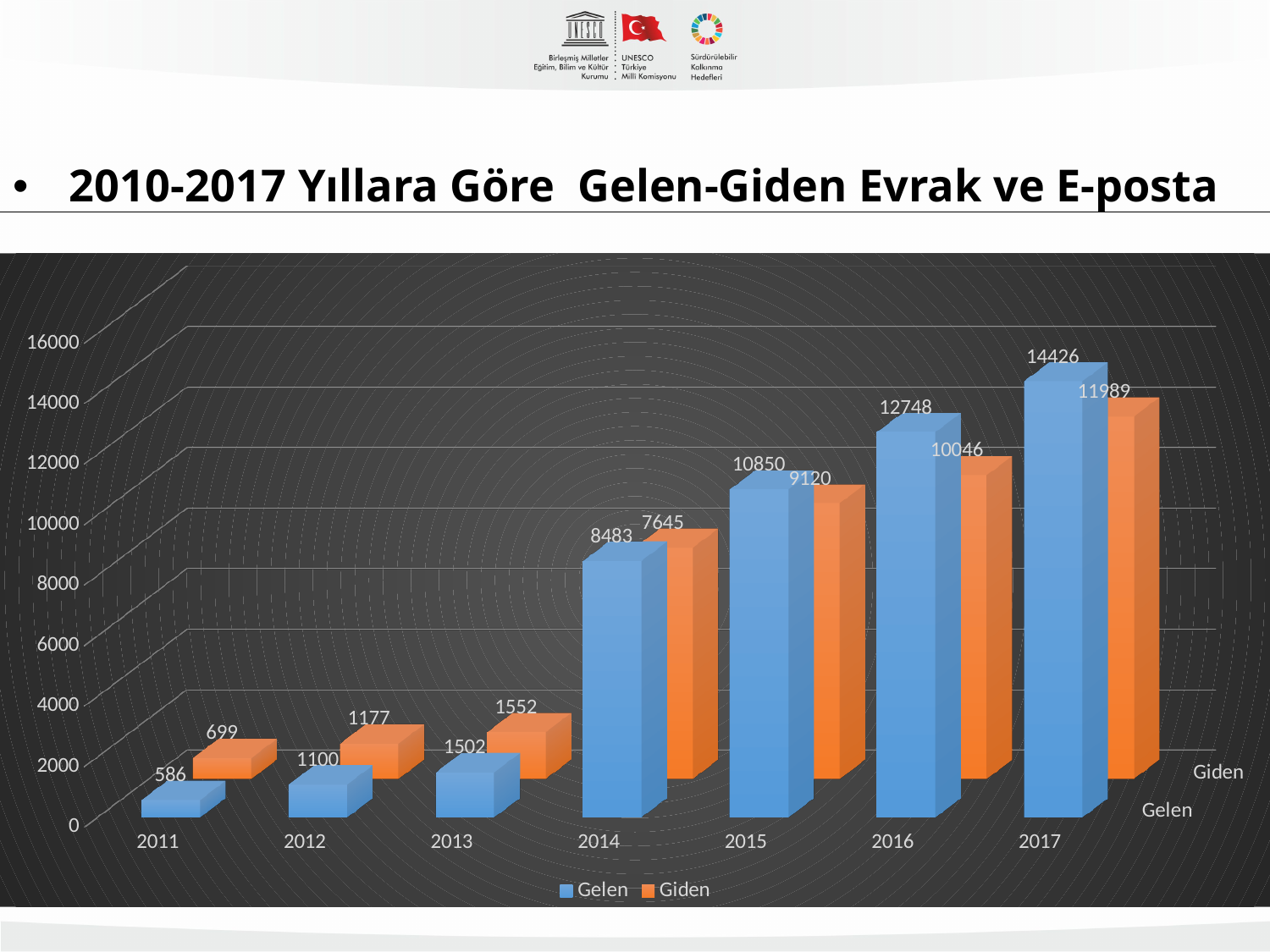
What is the Giden value for 2014? 7645 What is the Gelen value for 2011? 586 Which year has the highest Gelen value? 2017 What is the Giden value for 2016? 10046 Which year has the lowest Giden value? 2011 What is the difference between the Gelen and Giden values for 2015? 1730 Does the Gelen value rise or fall from 2011 to 2017? Rise What kind of chart is shown on the slide? Bar chart How many years are shown on the x axis? 7 What is the Gelen value for 2017? 14426 How many series does the legend list? 2 Which is larger in 2013, Gelen or Giden? Giden